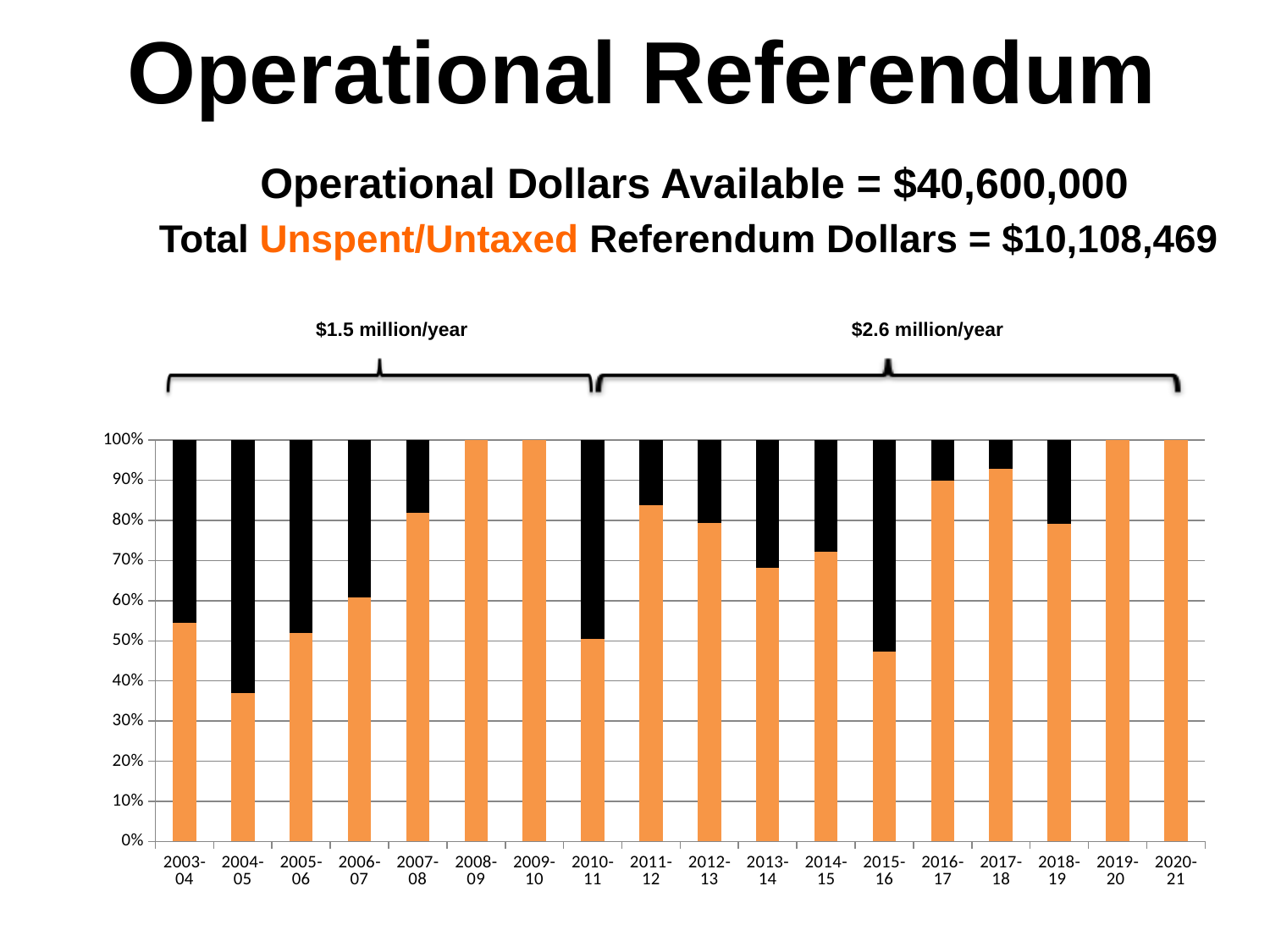
What annual amount is labelled above the bracket covering the first group of years in the chart? $1.5 million/year Which year has the smallest orange segment in the chart? 2004-05 Is the orange segment for 2016-17 greater or less than 80%? greater Is the orange segment for 2004-05 greater or less than 40%? less How many school years are shown along the x axis of the chart? 18 What kind of chart is shown on the slide? stacked bar chart Which year has the largest black segment in the chart? 2004-05 How many bars in the chart are entirely orange with no black segment? 4 Which year has the larger orange segment, 2015-16 or 2016-17? 2016-17 Is the orange segment for 2011-12 greater or less than 80%? greater What is the total height of each stacked bar in the chart? 100%